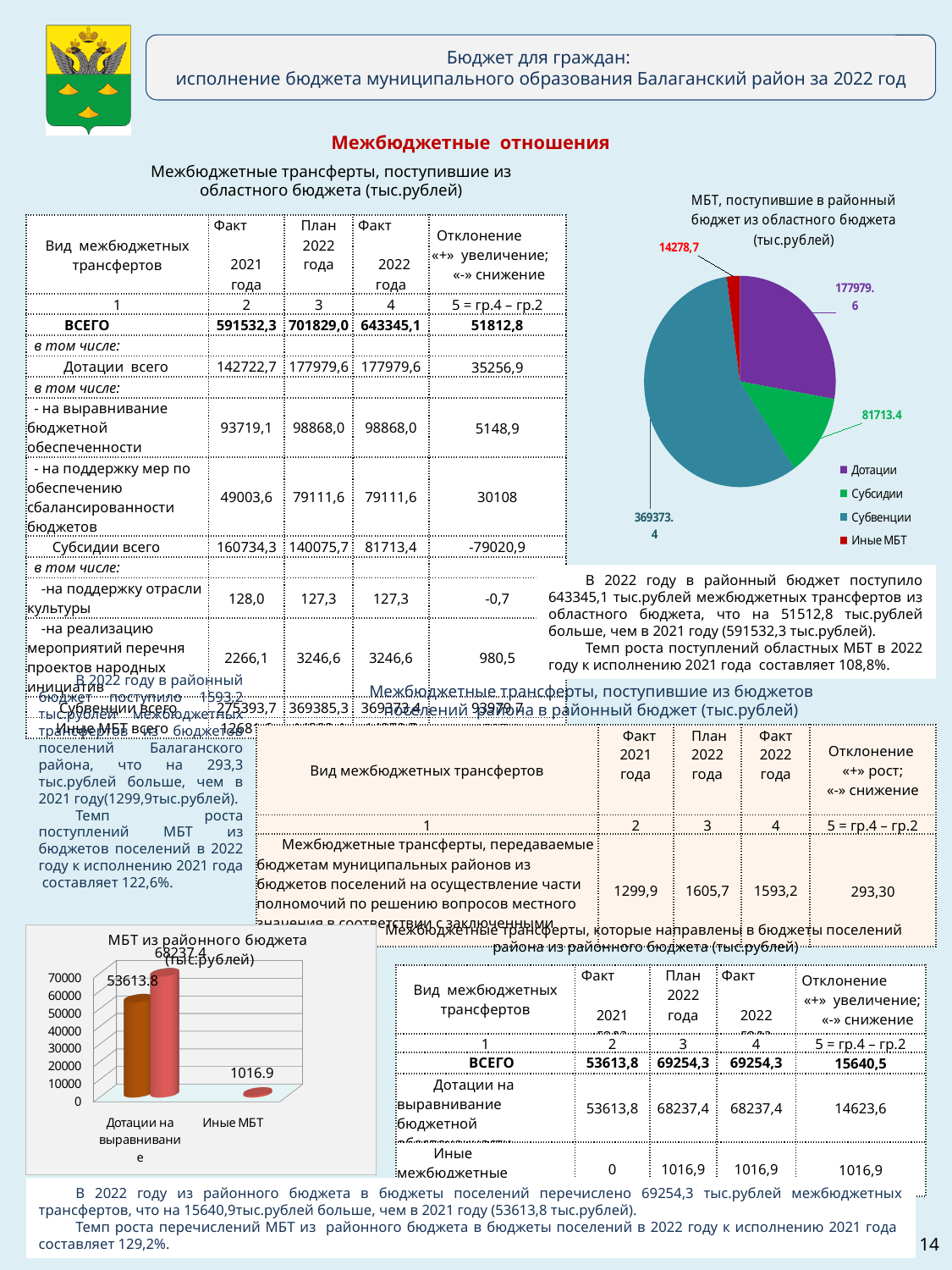
In the pie chart 'МБТ, поступившие в районный бюджет из областного бюджета', what is the value for Иные МБТ? 14278,7 In the pie chart 'МБТ, поступившие в районный бюджет из областного бюджета', which category has the largest slice? Субвенции How many categories does the legend of the pie chart 'МБТ, поступившие в районный бюджет из областного бюджета' list? 4 In the pie chart 'МБТ, поступившие в районный бюджет из областного бюджета', what is the value for Субвенции? 369373.4 In the pie chart 'МБТ, поступившие в районный бюджет из областного бюджета', what is the value for Дотации? 177979.6 In the pie chart 'МБТ, поступившие в районный бюджет из областного бюджета', what share of the total does Субвенции represent? 57.4% In the bar chart 'МБТ из районного бюджета (тыс.рублей)', what is the difference between the two bars for Дотации на выравнивание (68237.4 and 53613.8)? 14623.6 In the pie chart 'МБТ, поступившие в районный бюджет из областного бюджета', which is larger: Субсидии or Дотации? Дотации In the pie chart 'МБТ, поступившие в районный бюджет из областного бюджета', which category has the smallest slice? Иные МБТ In the bar chart 'МБТ из районного бюджета (тыс.рублей)', what is the value labelled for Иные МБТ? 1016.9 What type of chart is the chart titled 'МБТ, поступившие в районный бюджет из областного бюджета (тыс.рублей)'? pie chart What type of chart is the chart titled 'МБТ из районного бюджета (тыс.рублей)'? bar chart